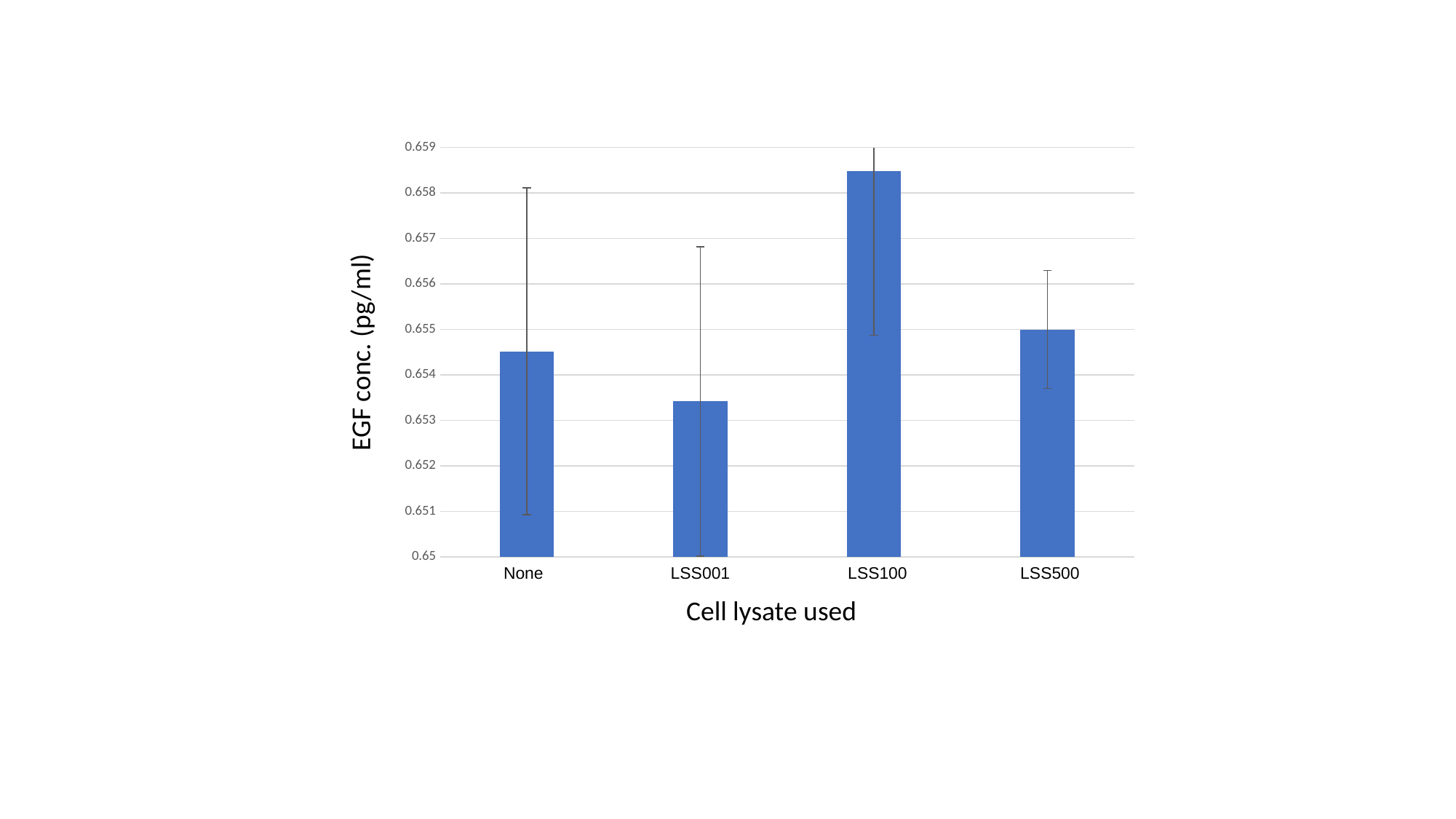
Is the EGF concentration for LSS500 greater or less than 0.654? greater What is the title of the y axis? EGF conc. (pg/ml) Which cell lysate has the highest EGF concentration? LSS100 What kind of chart is shown on the slide? bar chart What is the title of the x axis? Cell lysate used Is the EGF concentration for None greater or less than 0.654? greater Is the EGF concentration for LSS100 greater or less than 0.658? greater How many cell lysate categories are plotted on the x axis? 4 Which has the larger EGF concentration, LSS100 or LSS500? LSS100 Which cell lysate has the lowest EGF concentration? LSS001 Which has the larger EGF concentration, None or LSS001? None